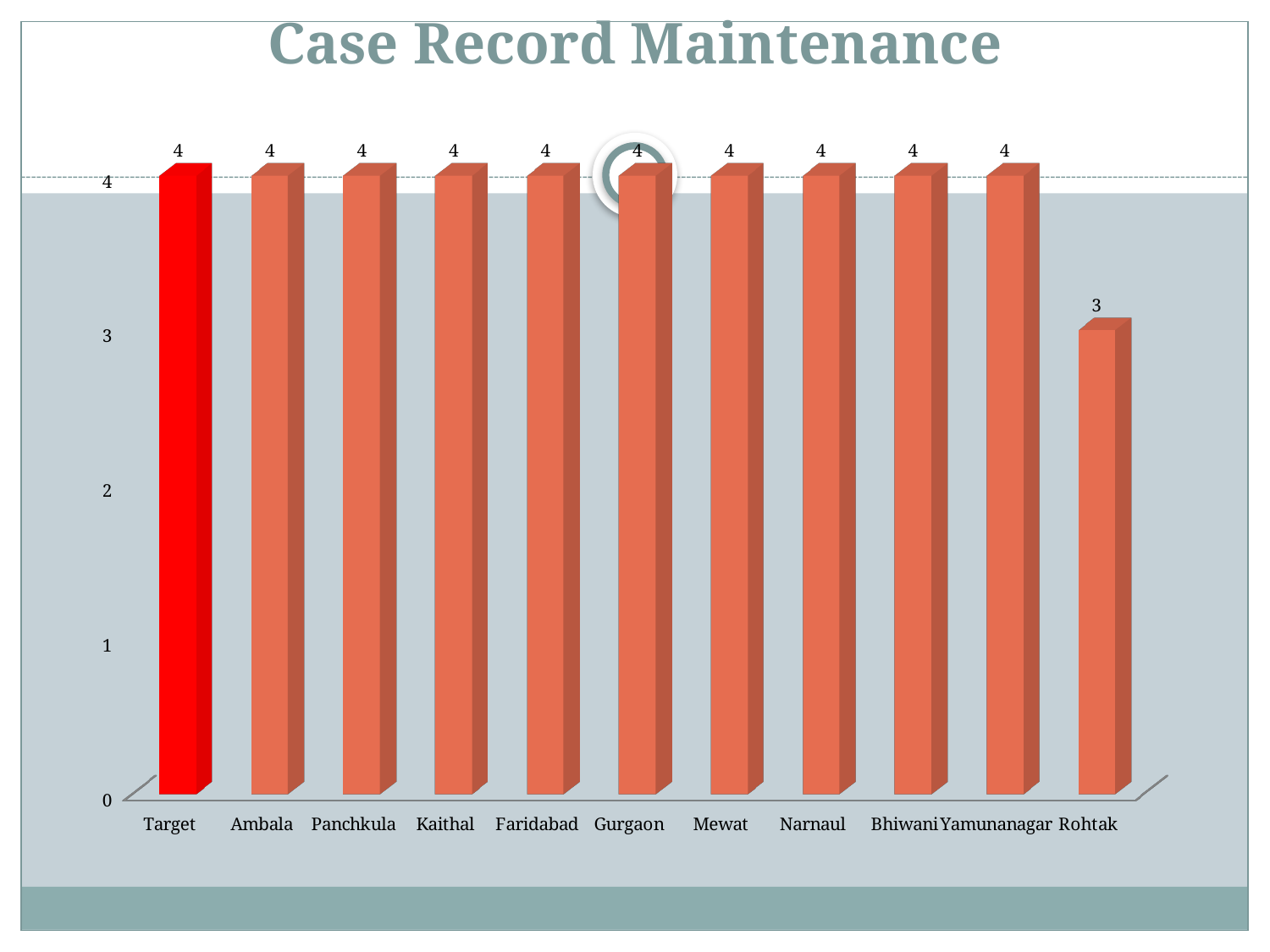
What is the value for Gurgaon? 4 How many categories are shown on the x axis? 11 How many categories have a value of 4? 10 Which is larger, the value for Bhiwani or the value for Rohtak? Bhiwani What is the value for Target? 4 Which category has the lowest value? Rohtak What is the title of the chart? Case Record Maintenance What kind of chart is shown on the slide? bar chart Is the value for Rohtak greater or less than 4? less What is the difference between the Target value and the Rohtak value? 1 Which bar is coloured differently (bright red) from the others? Target What is the value for Rohtak? 3